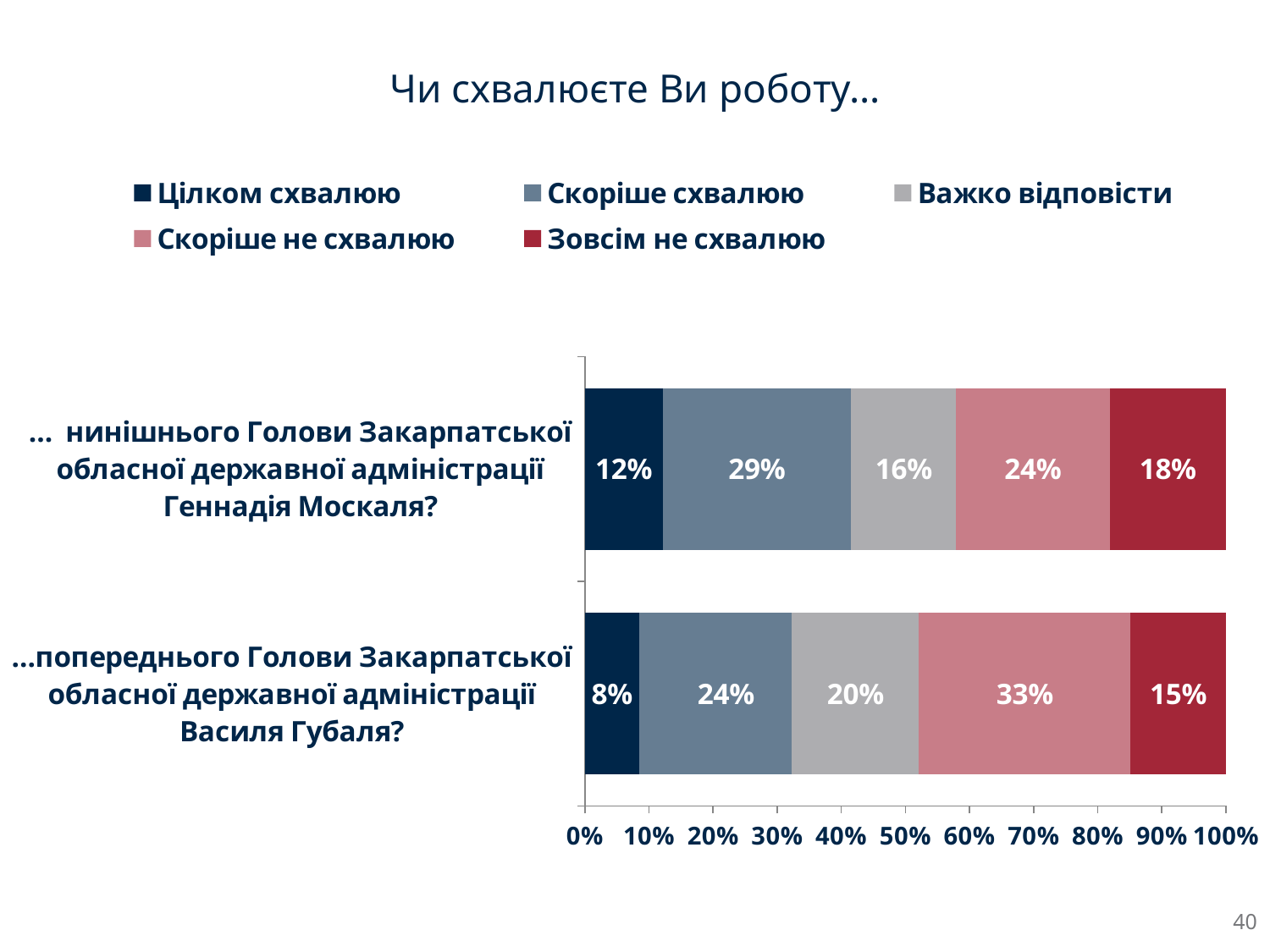
How many series does the legend list? 5 What percentage of respondents answered "Цілком схвалюю" for Геннадій Москаль? 12% Which response category has the largest share for Василь Губаль? Скоріше не схвалюю How many bars (categories) are shown in the chart? 2 What kind of chart is shown on the slide? Stacked bar chart What is the value of "Важко відповісти" for Геннадій Москаль? 16% What is the title of the slide? Чи схвалюєте Ви роботу… What percentage of respondents answered "Скоріше не схвалюю" for Василь Губаль? 33% What is the value of "Зовсім не схвалюю" for Василь Губаль? 15% What is the difference between the "Скоріше схвалюю" values for Геннадій Москаль and Василь Губаль? 5% Which is larger: "Зовсім не схвалюю" for Геннадій Москаль or for Василь Губаль? Геннадій Москаль Which response category has the smallest share for Геннадій Москаль? Цілком схвалюю